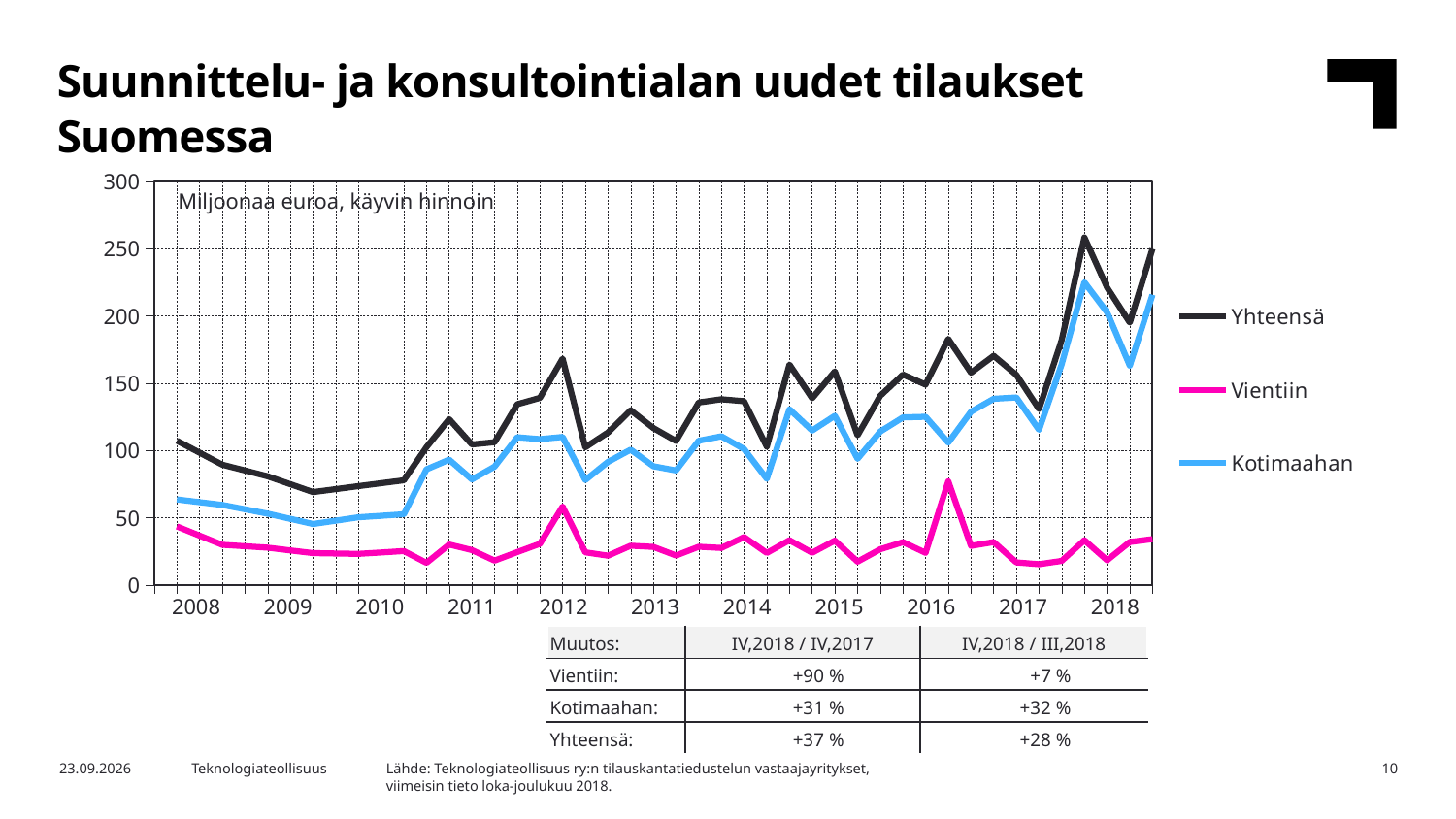
In 2012, which series is larger: Kotimaahan or Vientiin? Kotimaahan What unit note is printed inside the chart area? Miljoonaa euroa, käyvin hinnoin Which series has the lowest values across the whole chart? Vientiin What are the three series named in the chart legend? Yhteensä, Vientiin, Kotimaahan How many year labels are shown on the x axis? 11 Is the peak value of Vientiin in 2016 greater or less than 50? greater Does the Yhteensä line rise or fall from 2008 to 2009? fall How many series does the chart legend list? 3 Which series has the highest values across the whole chart? Yhteensä What kind of chart is shown on the slide? line chart Is the value for Kotimaahan at the start of 2008 greater or less than 100? less